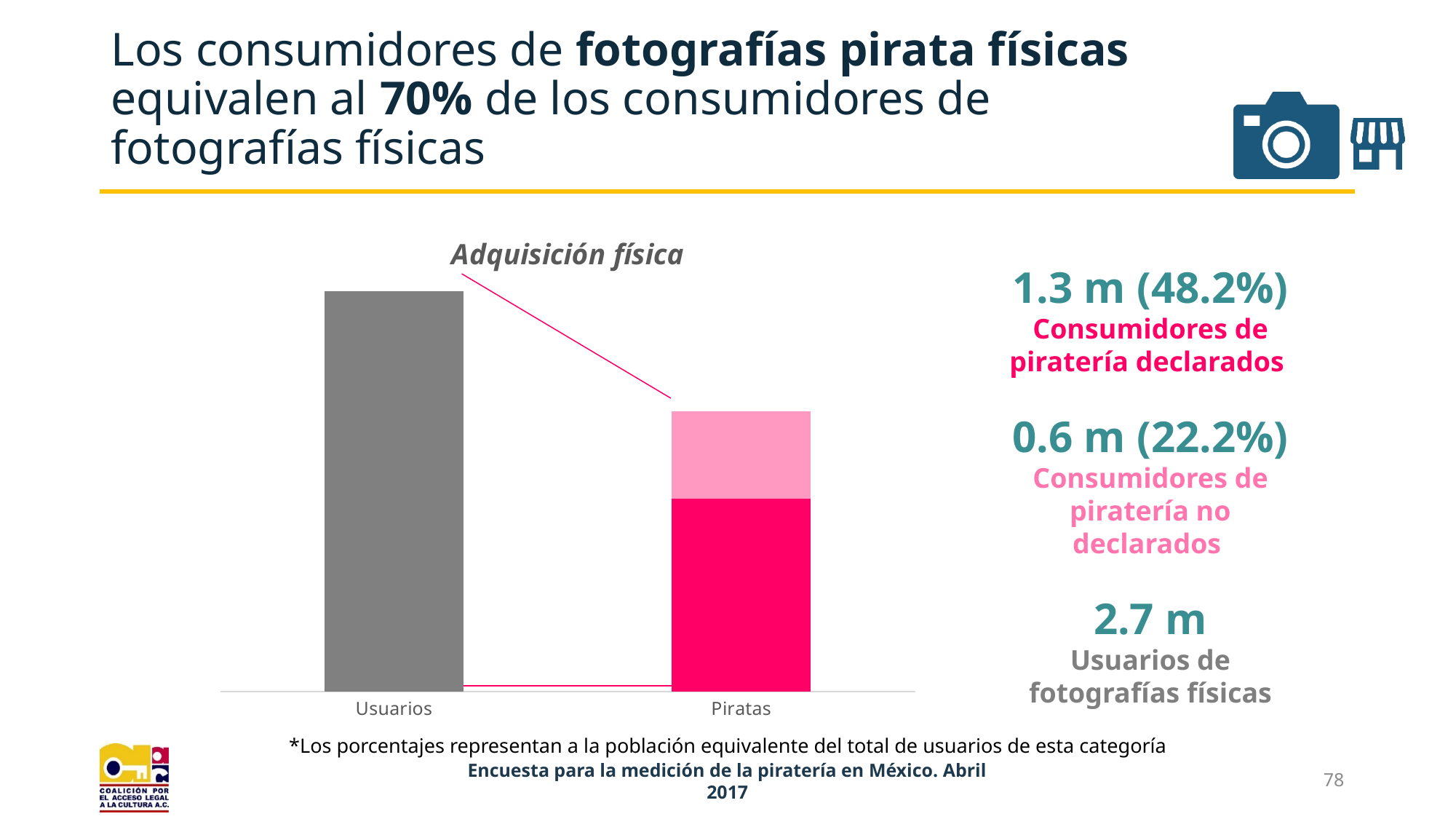
What value is given for Usuarios de fotografías físicas? 2.7 m How many categories are shown on the x axis of the chart? 2 Which category has the highest bar in the chart? Usuarios What is the difference between consumidores de piratería declarados (1.3 m) and no declarados (0.6 m)? 0.7 m What value is given for Consumidores de piratería declarados? 1.3 m (48.2%) What is the total of the stacked Piratas bar, combining declared and undeclared pirate consumers? 1.9 m Within the Piratas bar, which segment is larger: consumidores de piratería declarados or no declarados? Consumidores de piratería declarados What colour is the Usuarios bar? gray What is the title of the chart? Adquisición física What kind of chart is shown on the slide? bar chart Which category has the taller bar, Usuarios or Piratas? Usuarios What value is given for Consumidores de piratería no declarados? 0.6 m (22.2%)